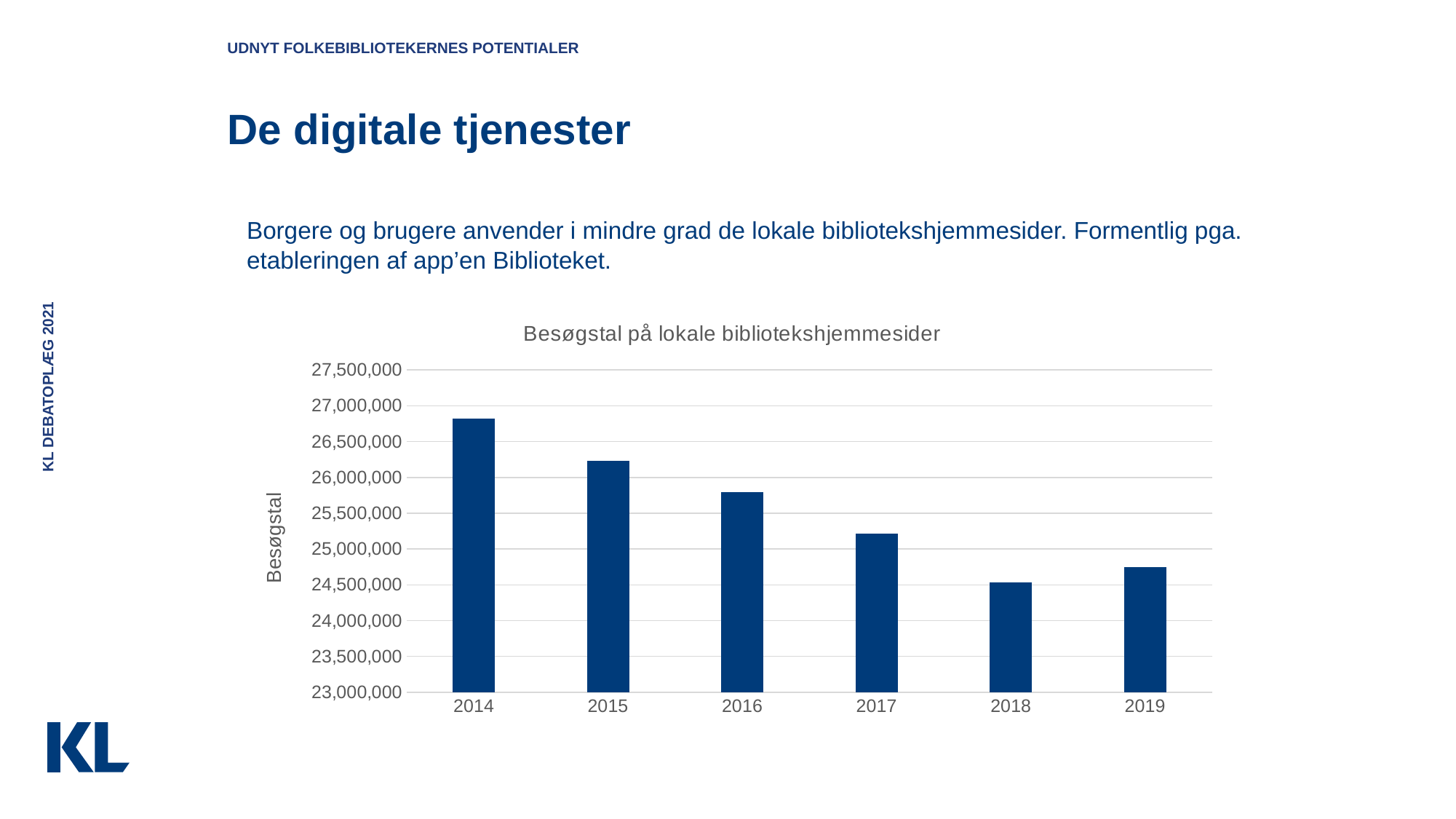
Do the visit numbers generally rise or fall from 2014 to 2018? fall What is the title of the chart? Besøgstal på lokale bibliotekshjemmesider Is the value for 2019 greater or less than 25,000,000? less Is the value for 2016 greater or less than 26,000,000? less How many years are shown on the x axis of the chart? 6 Which year has the highest number of visits in the chart? 2014 Which year has the lowest number of visits in the chart? 2018 What is the label on the vertical axis of the chart? Besøgstal Which year has the larger value, 2018 or 2019? 2019 Is the value for 2014 greater or less than 26,500,000? greater What kind of chart is shown on the slide? bar chart